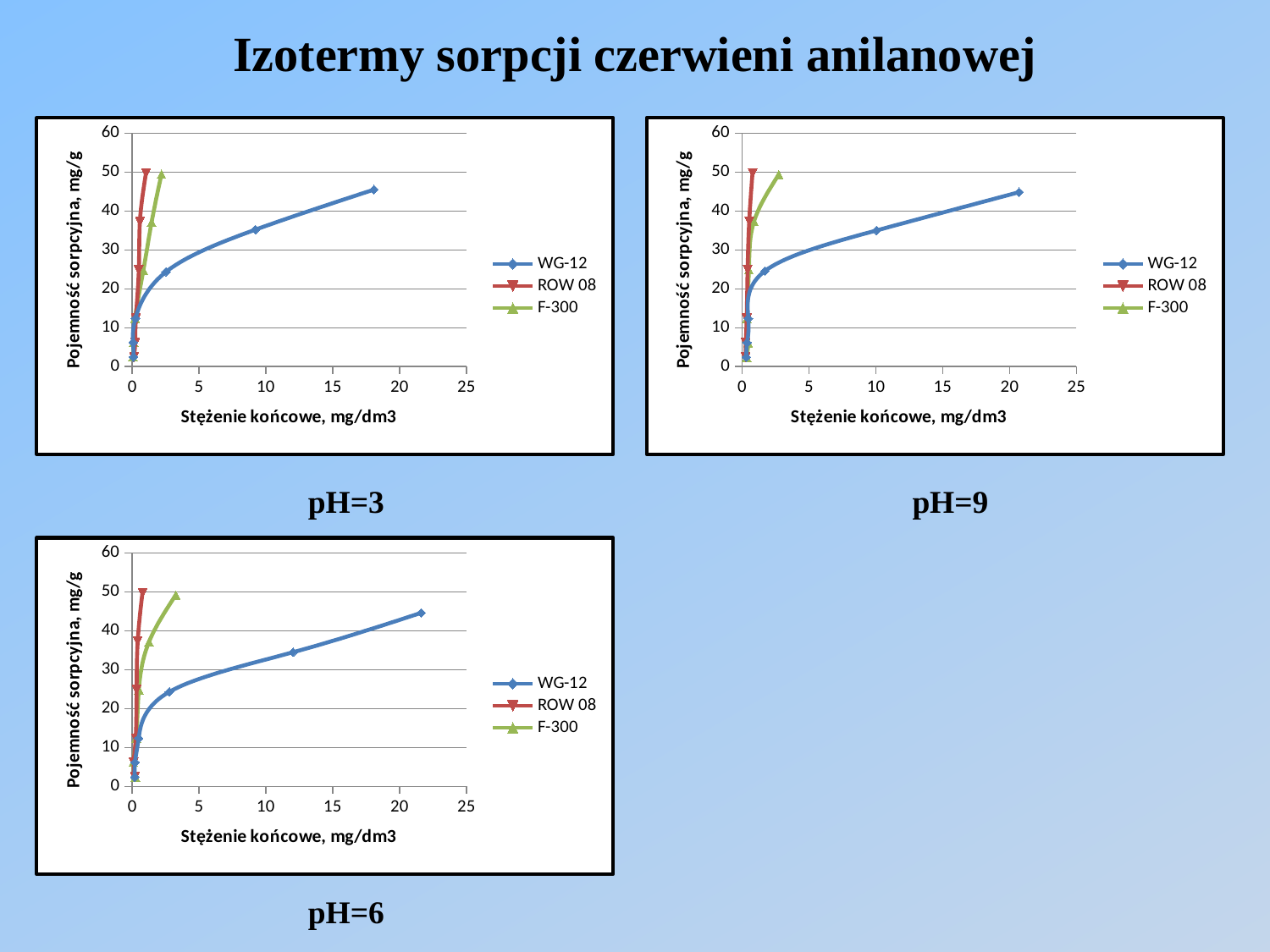
What is the title of the slide containing the three charts? Izotermy sorpcji czerwieni anilanowej What is the y-axis label of the pH=9 chart? Pojemność sorpcyjna, mg/g How many charts are shown on the slide? 3 In the pH=3 chart, does the sorption capacity of WG-12 rise or fall as the final concentration increases? rise What kind of chart is the pH=6 chart? line chart with markers (scatter) How many series does the legend of the pH=3 chart list? 3 In the pH=3 chart, is the final concentration of the rightmost WG-12 point greater or less than 20? less In the pH=6 chart, which series reaches a sorption capacity of about 50 mg/g at the lowest final concentration? ROW 08 In the pH=3 chart, is the highest sorption capacity reached by WG-12 greater or less than 40 mg/g? greater In the pH=9 chart, which series extends to the highest final concentration on the x axis? WG-12 In the pH=9 chart, is the highest sorption capacity reached by F-300 greater or less than 40 mg/g? greater